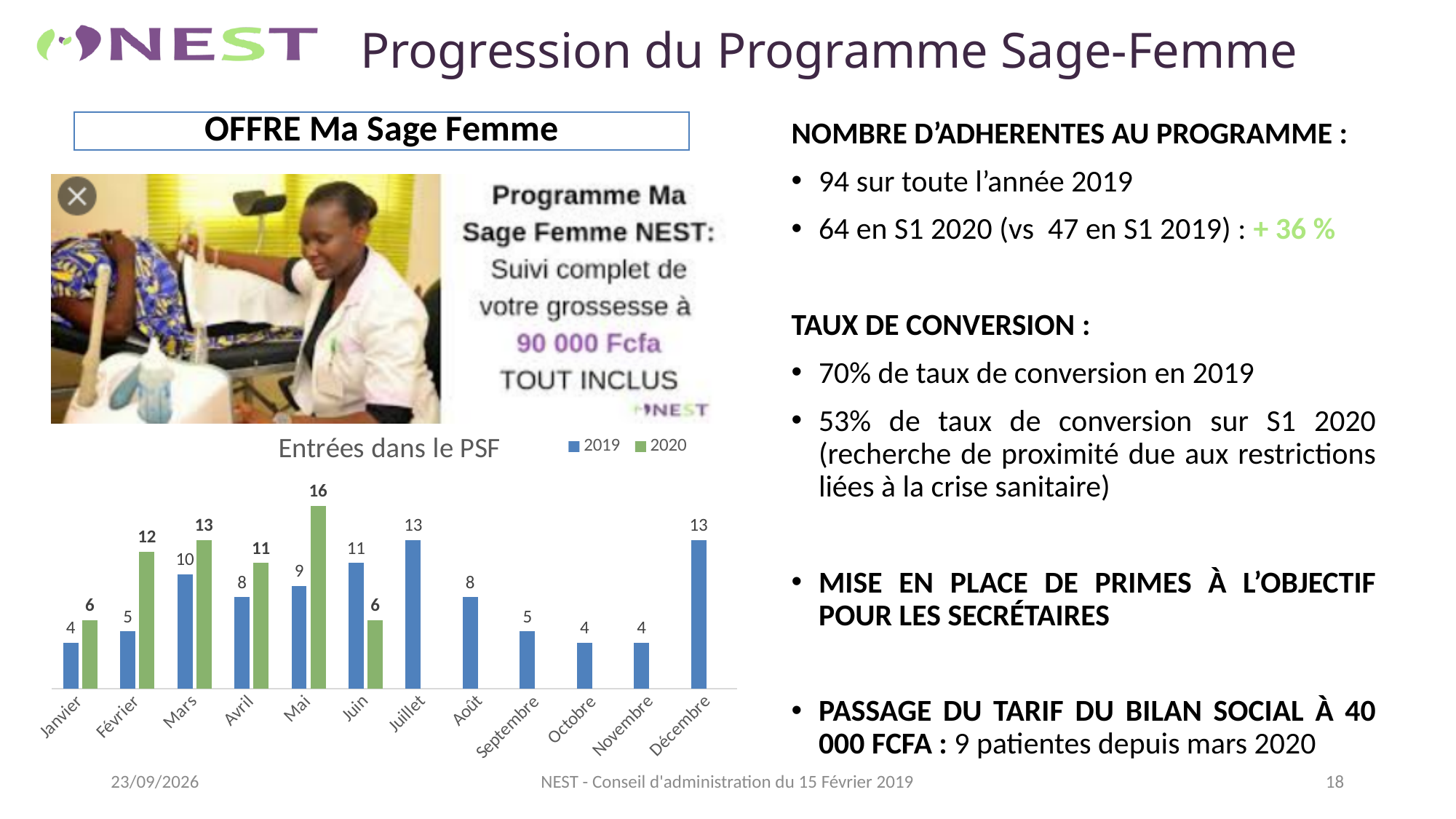
What is the value for 2019 in Septembre? 5 Do the 2019 values rise or fall from Août to Octobre? fall What is the difference between the 2020 and 2019 values in Février? 7 What is the value for 2019 in Juillet? 13 How many series does the chart legend list? 2 Which month has the highest value for the 2020 series? Mai Which colour represents the 2020 series in the chart? green What is the title of the chart on the slide? Entrées dans le PSF What is the value for 2020 in Mai? 16 How many months are shown on the x axis of the chart? 12 What type of chart is shown on the slide? bar chart Which is larger in Juin, the 2019 value or the 2020 value? 2019